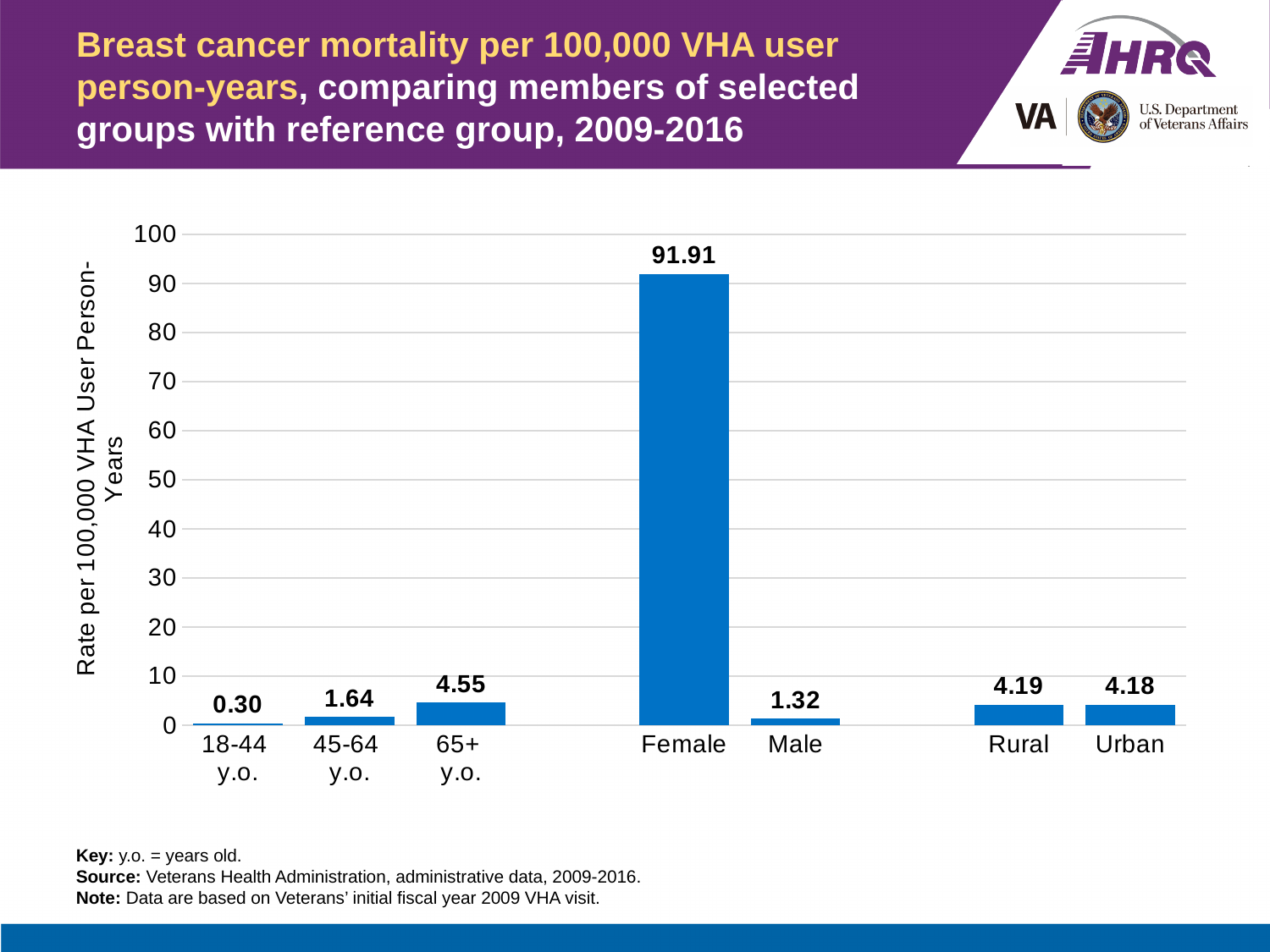
What is the difference between the 65+ y.o. and 45-64 y.o. breast cancer mortality rates? 2.91 What kind of chart is shown on the slide? Bar chart Which has a higher breast cancer mortality rate, 45-64 y.o. or Male? 45-64 y.o. What is the breast cancer mortality rate for the 18-44 y.o. group? 0.30 What is the breast cancer mortality rate for Rural? 4.19 How many categories are shown in the chart? 7 What is the difference between the Female and Male breast cancer mortality rates? 90.59 Which category has the lowest breast cancer mortality rate? 18-44 y.o. What is the breast cancer mortality rate for the 65+ y.o. group? 4.55 Is the value for Female greater or less than 90? greater What is the breast cancer mortality rate for Female? 91.91 Which category has the highest breast cancer mortality rate? Female